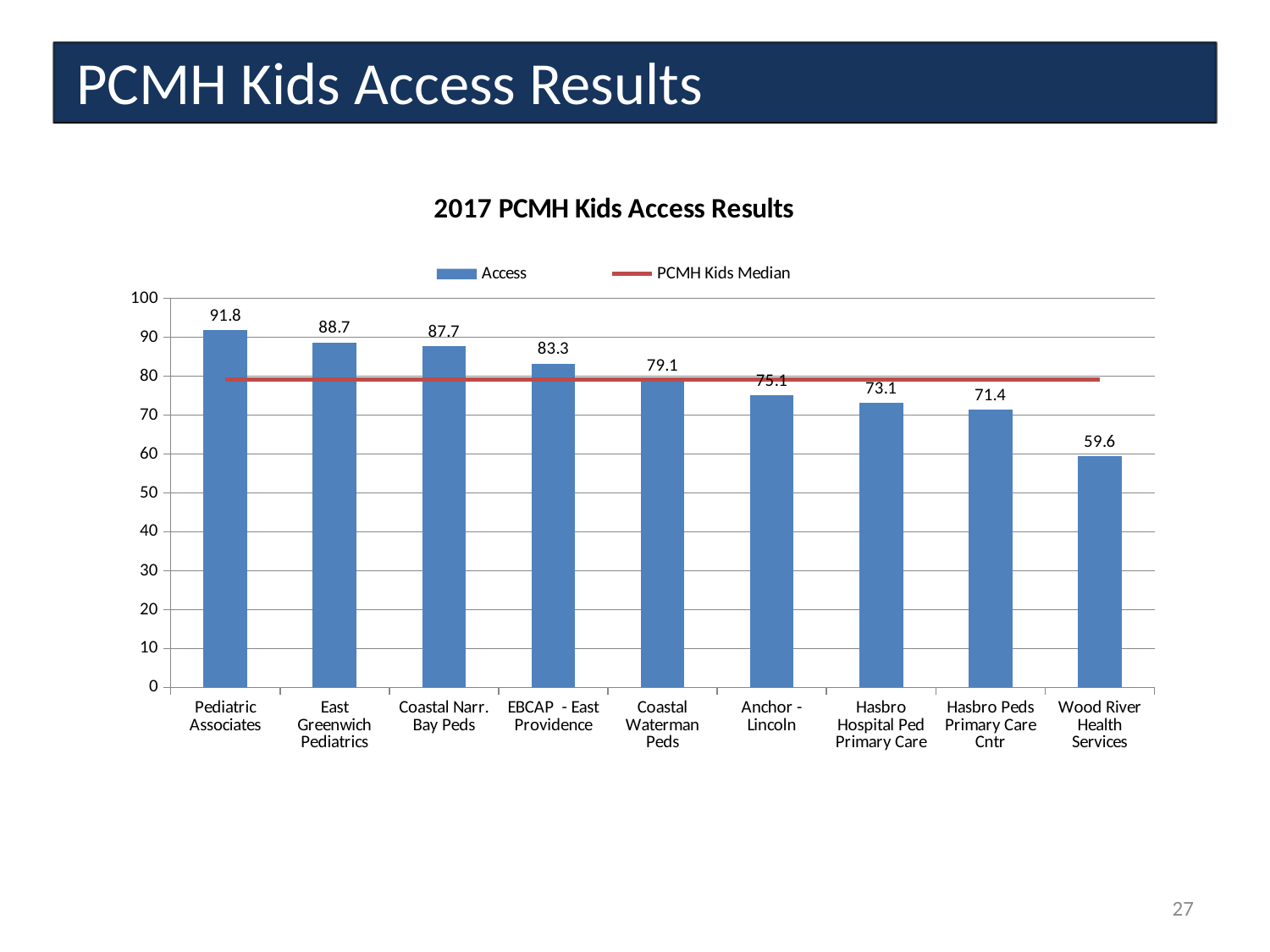
What is the Access value for Hasbro Peds Primary Care Cntr? 71.4 Is the Access value for EBCAP - East Providence greater or less than 80? greater What is the title of the chart? 2017 PCMH Kids Access Results How many practices are shown on the x axis? 9 Which has a higher Access value, Anchor - Lincoln or Hasbro Hospital Ped Primary Care? Anchor - Lincoln Which practice has the lowest Access value? Wood River Health Services What is the difference between the Access values for East Greenwich Pediatrics and Coastal Narr. Bay Peds? 1.0 What is the Access value for Coastal Waterman Peds? 79.1 What is the difference between the Access values for Pediatric Associates and Wood River Health Services? 32.2 How many series does the legend list? 2 What is the Access value for Pediatric Associates? 91.8 Which practice has the highest Access value? Pediatric Associates